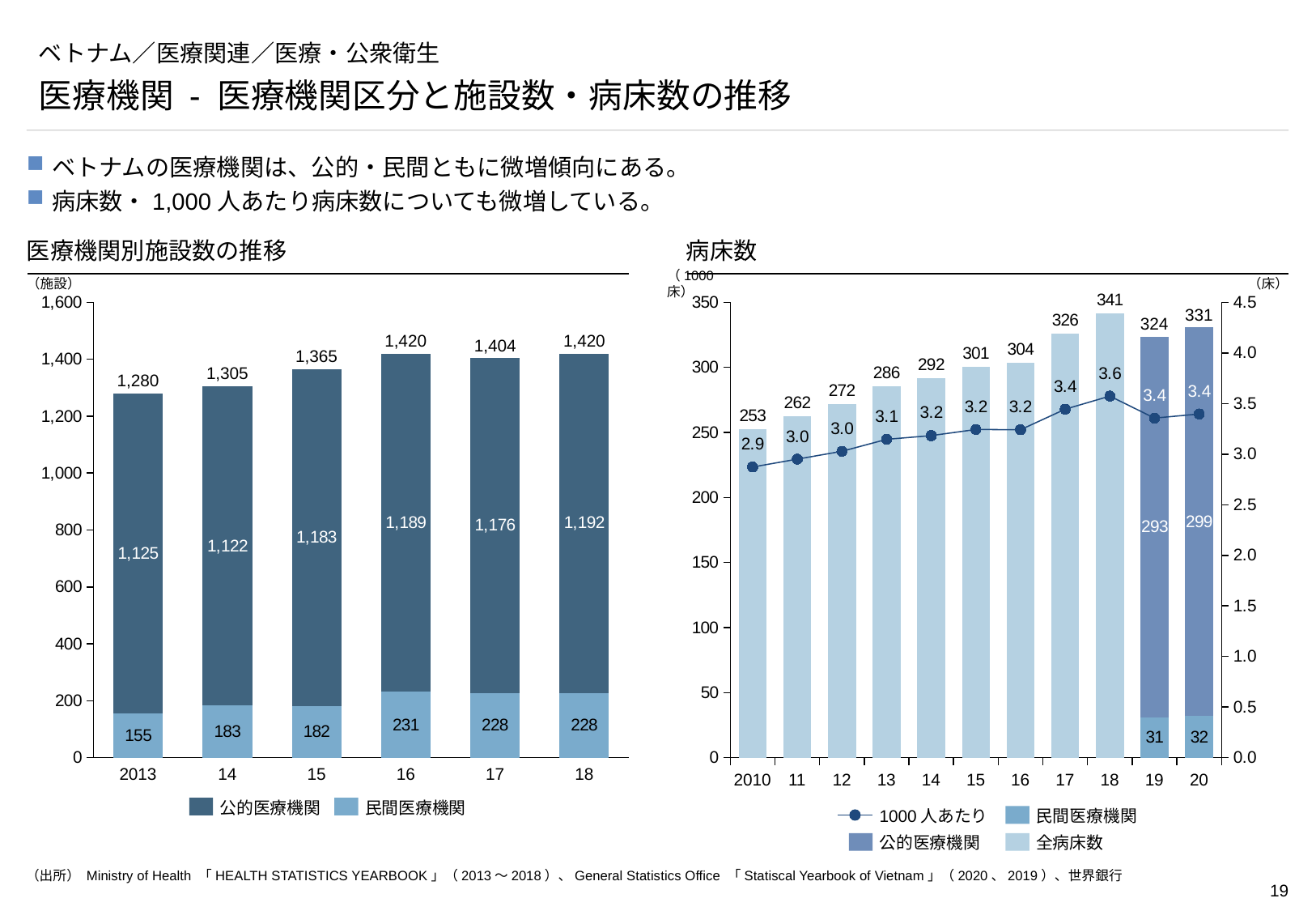
In the left chart (医療機関別施設数の推移), how many series does the legend list? 2 In the right chart (病床数), what is the total number of beds shown for 2018? 341 In the right chart (病床数), what is the 1000人あたり value for 2010? 2.9 In the left chart (医療機関別施設数の推移), what is the value for 民間医療機関 in 2016? 231 In the left chart (医療機関別施設数の推移), what is the total number of facilities shown for 2017? 1,404 In the left chart (医療機関別施設数の推移), which year has the lowest total number of facilities? 2013 In the left chart (医療機関別施設数の推移), what is the difference between the 民間医療機関 values for 2016 and 2013? 76 In the right chart (病床数), what is the value for 公的医療機関 in 2020? 299 In the right chart (病床数), which year has the highest total number of beds? 2018 In the left chart (医療機関別施設数の推移), what is the value for 公的医療機関 in 2015? 1,183 In the left chart (医療機関別施設数の推移), how many years are shown on the x axis? 6 In the right chart (病床数), how many entries does the legend list? 4